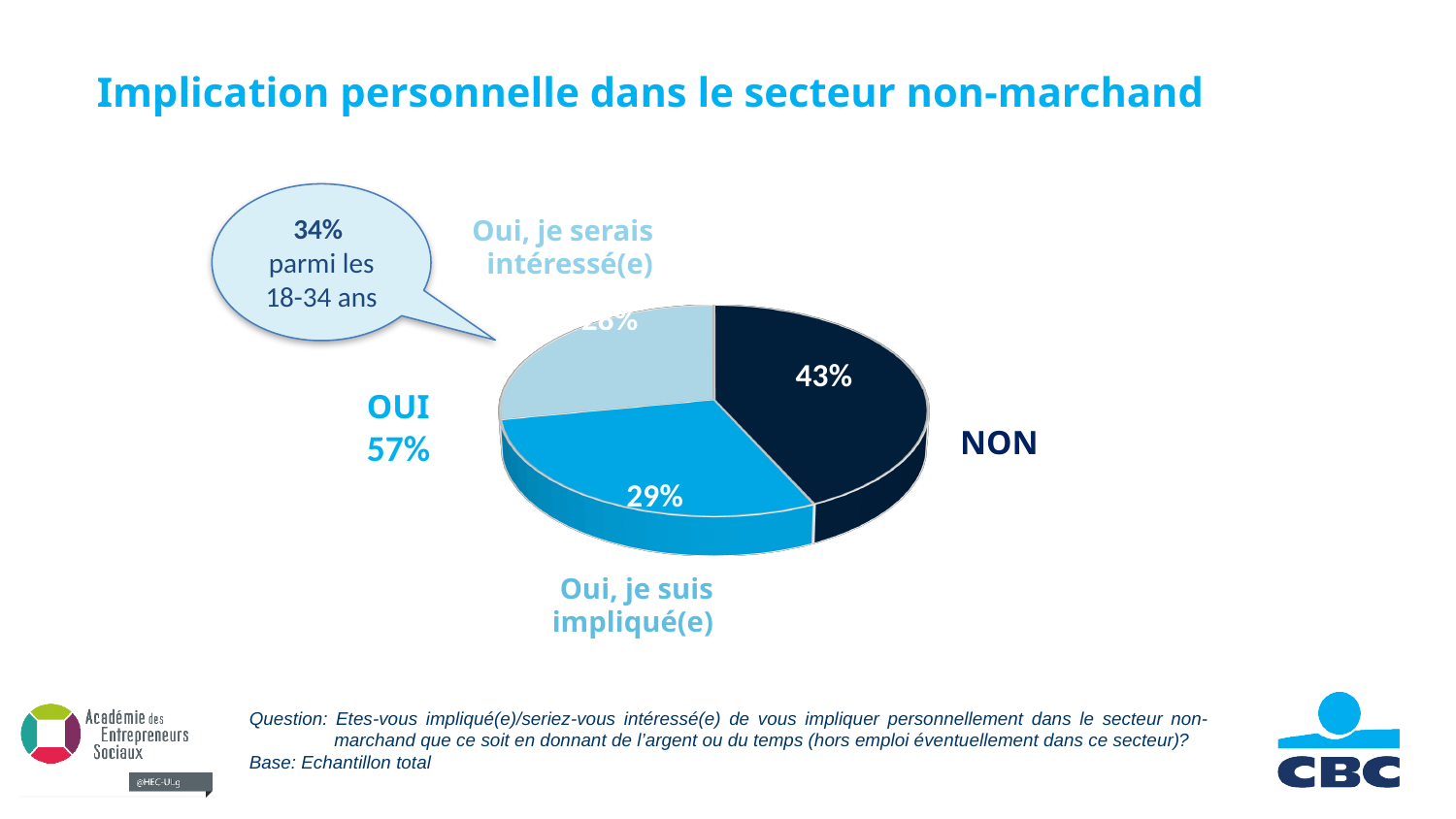
Is the NON slice greater or less than 50% of the pie? less Which is larger: the NON slice or the "Oui, je suis impliqué(e)" slice? NON What percentage of respondents answered "Oui, je suis impliqué(e)"? 29% What is the title of the slide? Implication personnelle dans le secteur non-marchand What combined share of the pie is labelled OUI? 57% Which slice of the pie chart is the largest? NON Which slice is shown in the darkest colour? NON What percentage of respondents answered NON? 43% What is the difference in percentage points between the NON slice and the "Oui, je suis impliqué(e)" slice? 14 percentage points What kind of chart is shown on the slide? pie chart According to the callout, what percentage is reported among the 18-34 year olds? 34% How many slices does the pie chart have? 3